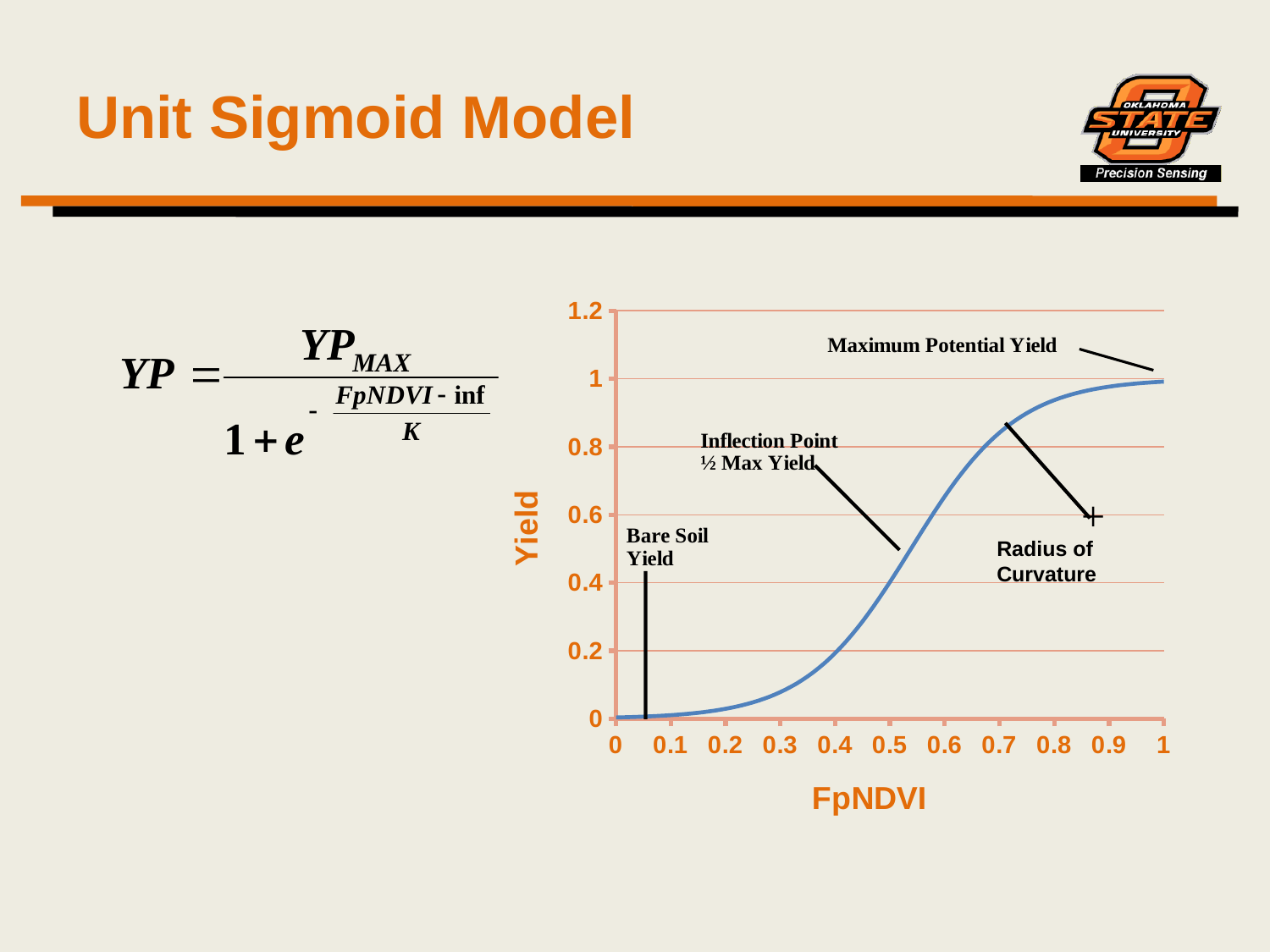
Is the Yield value at FpNDVI 0.3 greater or less than 0.2? less Does Yield rise or fall as FpNDVI increases along the x axis? rise Is the Yield value at FpNDVI 0.2 greater or less than 0.2? less Is the Yield value at FpNDVI 0.5 greater or less than 0.6? less What is the label of the x axis of the chart? FpNDVI What is the label of the y axis of the chart? Yield What kind of chart is shown on the slide? line chart Which of the two FpNDVI values, 0.4 or 0.8, has the larger Yield? 0.8